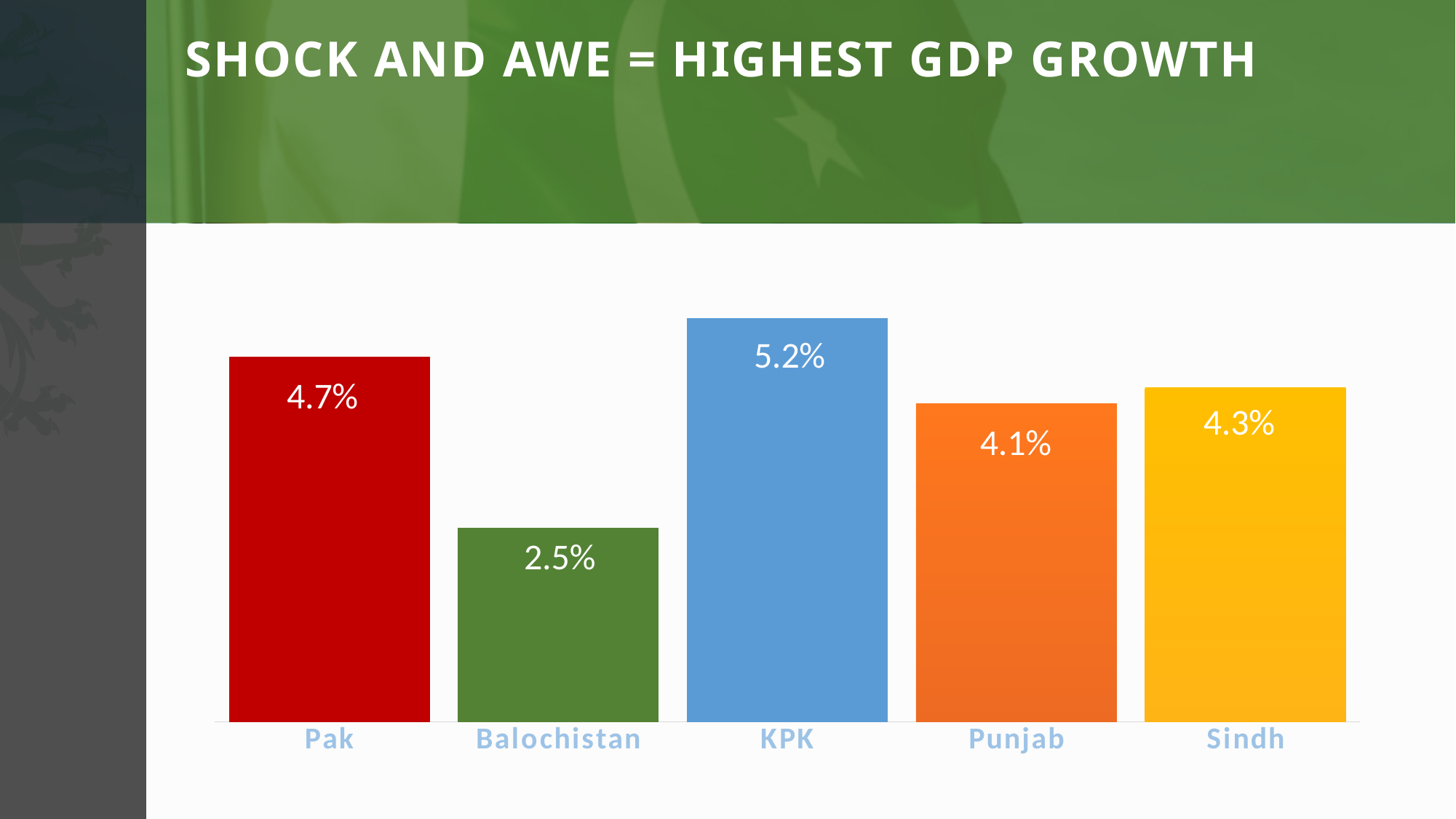
Which category has the highest value? KPK Which is larger, the value for Sindh or the value for Punjab? Sindh How many categories are shown in the chart? 5 Which category has the lowest value? Balochistan What kind of chart is shown on the slide? Bar chart What is the title of the slide? SHOCK AND AWE = HIGHEST GDP GROWTH What is the value for Sindh? 4.3% What is the value for KPK? 5.2% What is the difference between the values for Pak and Punjab? 0.6% What is the value for Balochistan? 2.5% What is the value for Pak? 4.7% What is the difference between the values for KPK and Balochistan? 2.7%